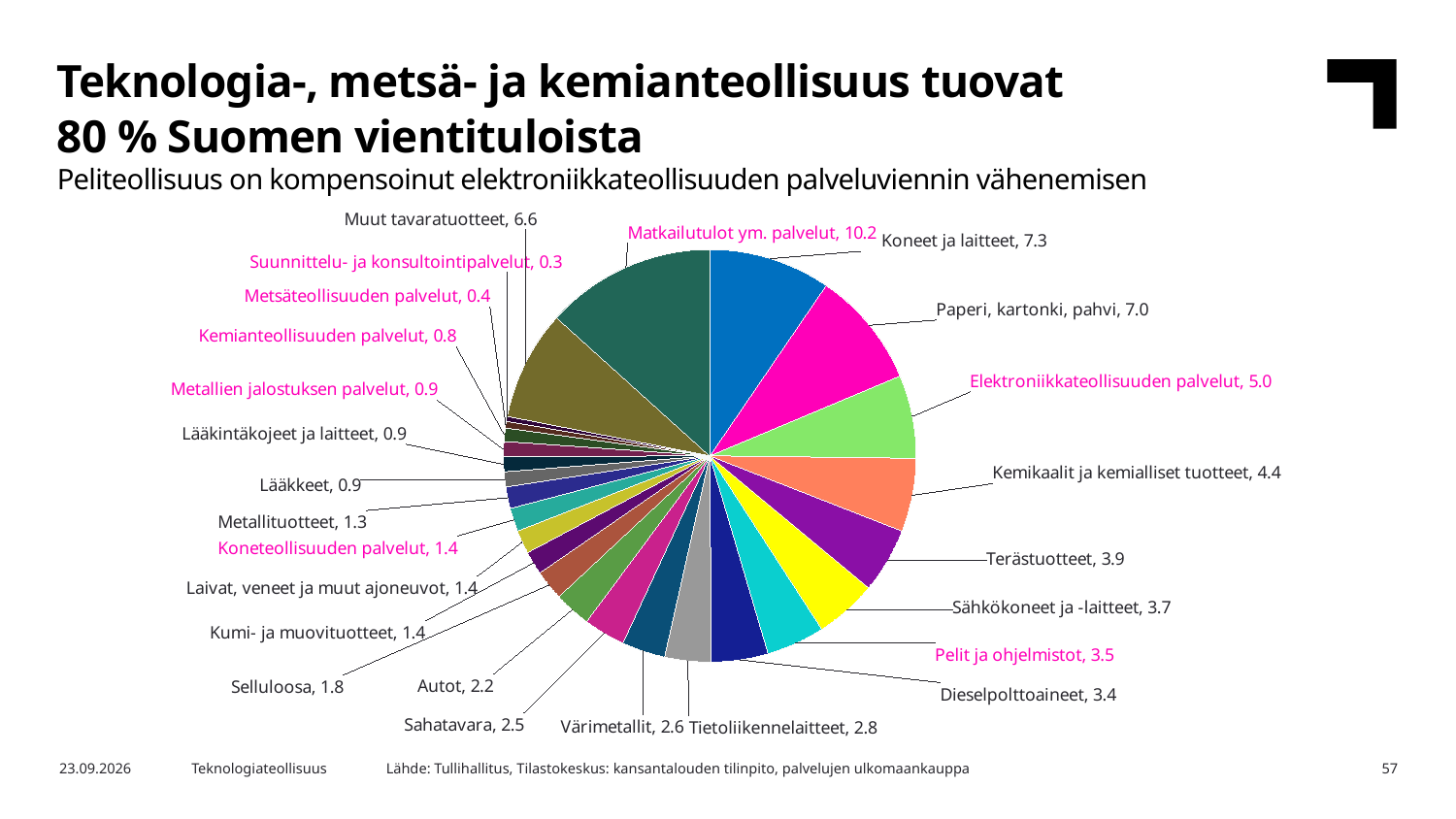
How many categories (slices) does the pie chart have? 25 Which category has the smallest slice of the pie? Suunnittelu- ja konsultointipalvelut What is the value for Elektroniikkateollisuuden palvelut? 5.0 What is the value for Pelit ja ohjelmistot? 3.5 What is the difference between the values for Matkailutulot ym. palvelut and Muut tavaratuotteet? 3.6 What is the value for Matkailutulot ym. palvelut? 10.2 What is the difference between the values for Koneet ja laitteet and Paperi, kartonki, pahvi? 0.3 Which category has the largest slice of the pie? Matkailutulot ym. palvelut What kind of chart is shown on the slide? pie chart What is the value for Suunnittelu- ja konsultointipalvelut? 0.3 What is the value for Paperi, kartonki, pahvi? 7.0 Which is larger, the value for Terästuotteet or the value for Dieselpolttoaineet? Terästuotteet